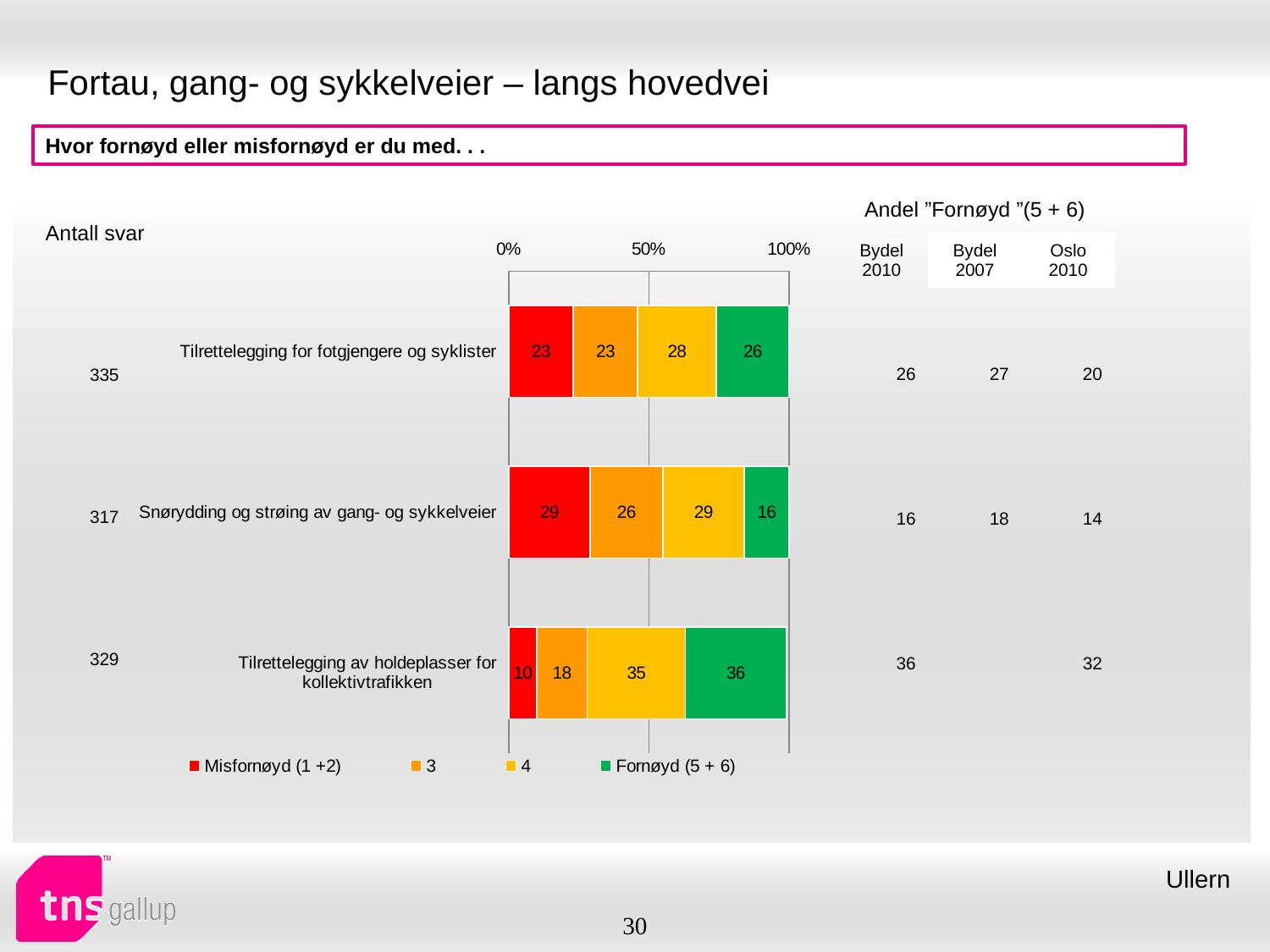
How many series does the legend list? 4 Which category has the lowest Misfornøyd (1 +2) value? Tilrettelegging av holdeplasser for kollektivtrafikken What kind of chart is shown on the slide? Stacked bar chart What is the difference between the Fornøyd (5 + 6) values for "Tilrettelegging av holdeplasser for kollektivtrafikken" and "Snørydding og strøing av gang- og sykkelveier"? 20 How many categories are shown in the bar chart? 3 Which has the larger Misfornøyd (1 +2) value: "Snørydding og strøing av gang- og sykkelveier" or "Tilrettelegging for fotgjengere og syklister"? Snørydding og strøing av gang- og sykkelveier What is the value of the Misfornøyd (1 +2) segment for "Tilrettelegging av holdeplasser for kollektivtrafikken"? 10 What is the value of the "4" segment for "Tilrettelegging for fotgjengere og syklister"? 28 What is the value of the Fornøyd (5 + 6) segment for "Snørydding og strøing av gang- og sykkelveier"? 16 What colour represents Fornøyd (5 + 6) in the legend? Green What is the difference between the "4" segment values for "Tilrettelegging av holdeplasser for kollektivtrafikken" and "Tilrettelegging for fotgjengere og syklister"? 7 Which category has the highest Fornøyd (5 + 6) value? Tilrettelegging av holdeplasser for kollektivtrafikken